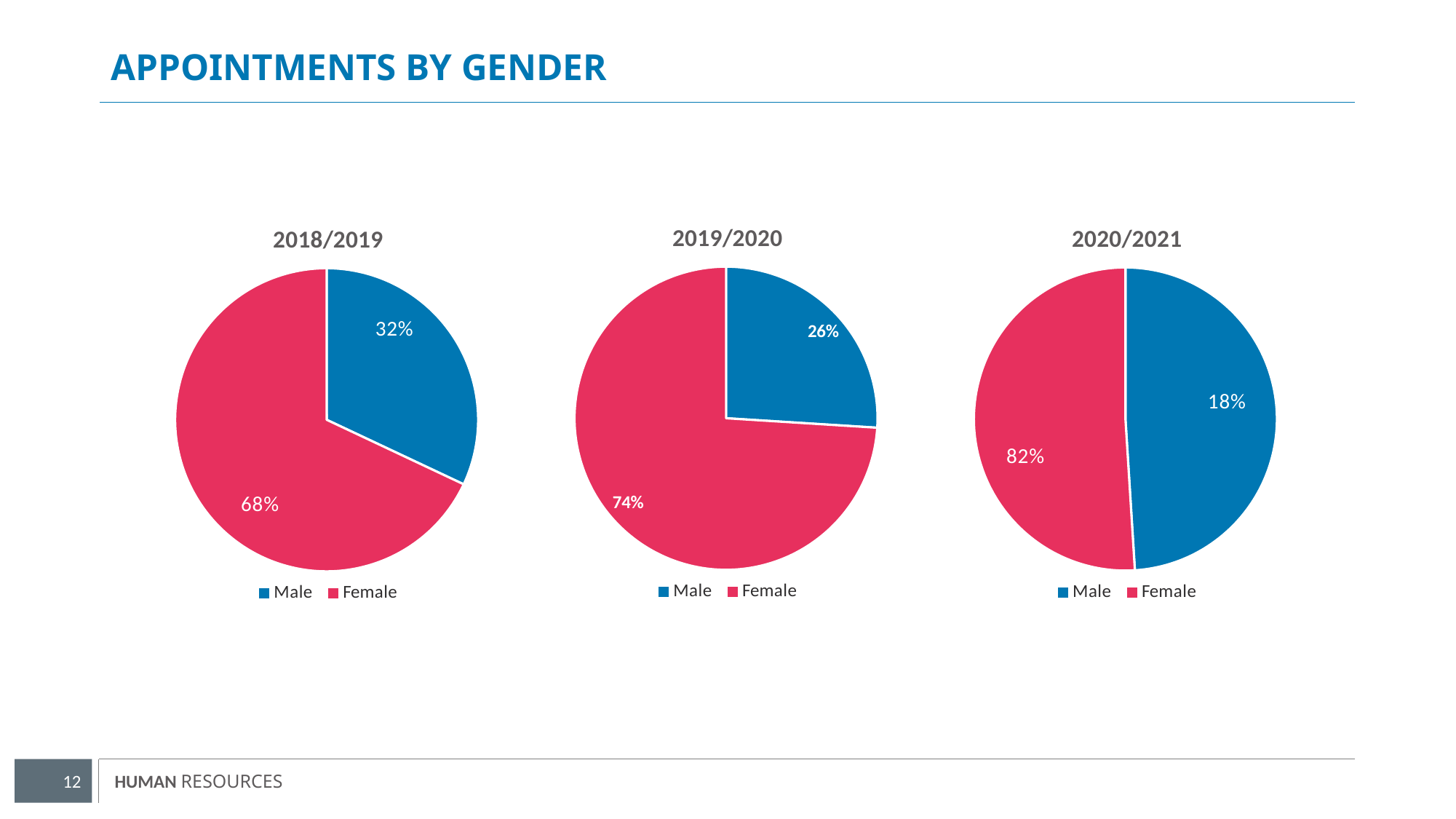
In the 2019/2020 pie chart, what percentage of appointments were Female? 74% In the 2019/2020 pie chart, what share of appointments were Male? 26% In the 2018/2019 pie chart, what percentage of appointments were Female? 68% In the 2018/2019 pie chart, what percentage of appointments were Male? 32% Across the three pie charts from 2018/2019 to 2020/2021, does the labelled Male percentage rise or fall over time? Fall In the 2019/2020 pie chart, which colour represents Female? Red In the 2020/2021 pie chart, what percentage is labelled for Female? 82% In the 2020/2021 pie chart, what percentage is labelled for Male? 18% In the 2019/2020 pie chart, which category has the larger share, Male or Female? Female How many categories does the legend of the 2020/2021 pie chart list? 2 What kind of chart is used for 2018/2019? Pie chart In the 2018/2019 pie chart, what is the difference between the Female and Male percentages? 36%